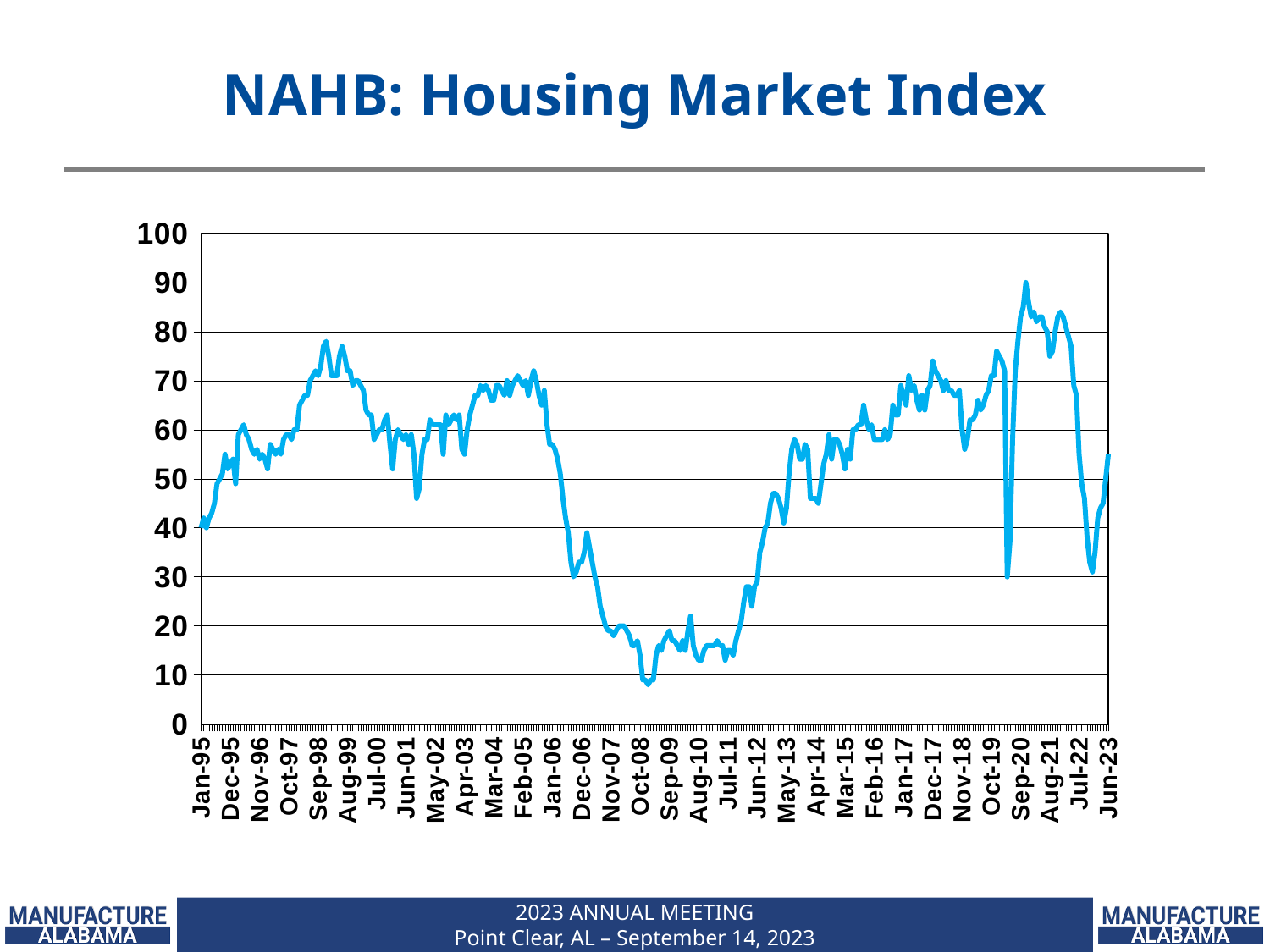
What kind of chart is shown on the slide? line chart Is the value for Jan-95 greater or less than 50? less Which has the larger value, Sep-98 or Oct-08? Sep-98 Is the value for Jul-11 greater or less than 30? less What is the title of the chart? NAHB: Housing Market Index Is the value for Oct-08 greater or less than 20? less Does the index rise or fall between Jan-06 and Oct-08? fall What is the last x-axis label on the chart? Jun-23 How many lines (series) are plotted on the chart? 1